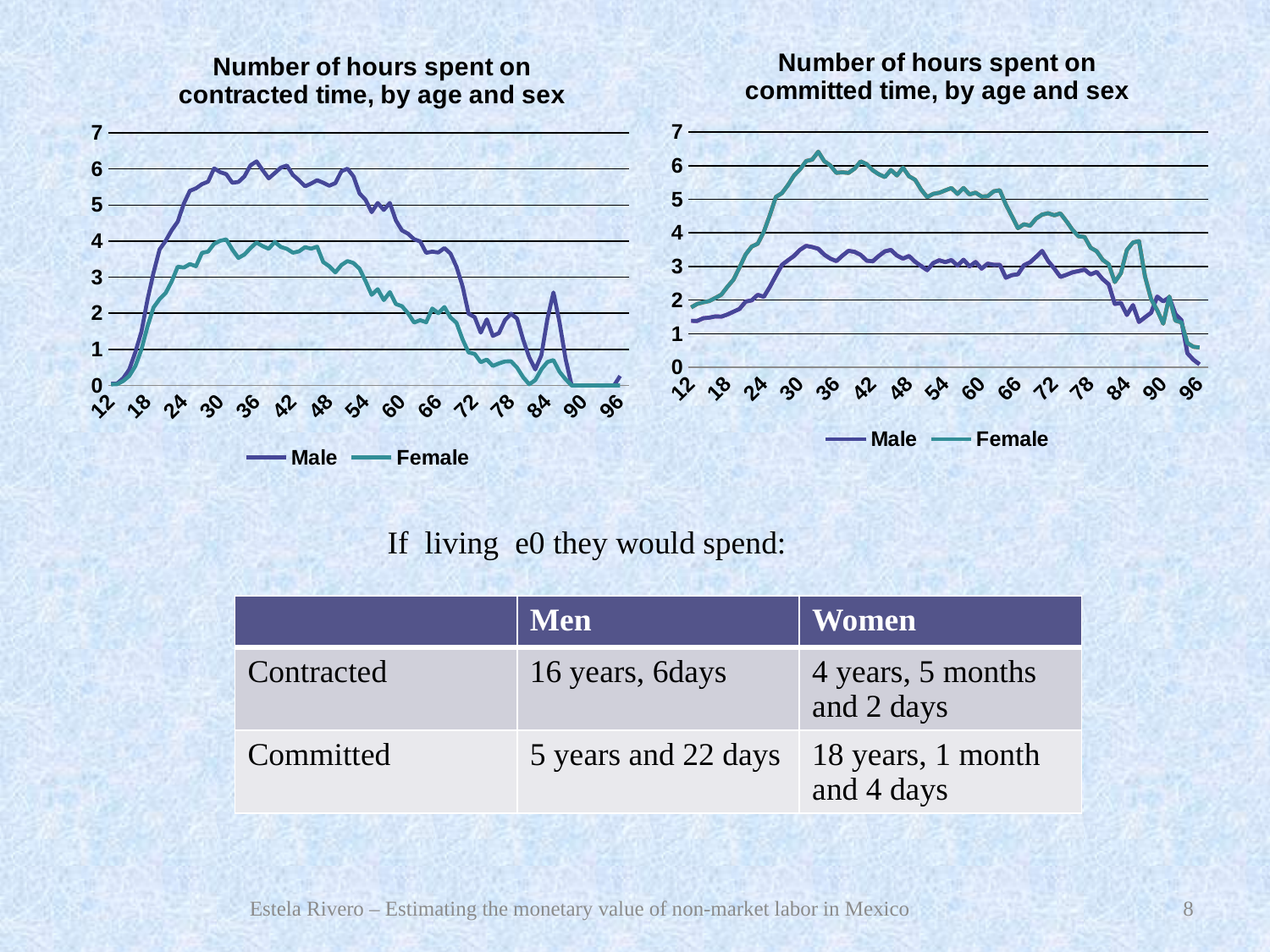
In the right chart (committed time), is the Female value at age 30 greater or less than 5? greater In the left chart (contracted time), does the Male line rise or fall between age 54 and age 90? fall How many series does the legend of the right chart, 'Number of hours spent on committed time, by age and sex', list? 2 In the right chart (committed time), is the Male value at age 12 greater or less than 1? greater In the left chart (contracted time), is the Male value at age 90 greater or less than 1? less What kind of chart is the left chart, 'Number of hours spent on contracted time, by age and sex'? line chart In the right chart (committed time), at age 42, which series has the larger value, Male or Female? Female In the left chart (contracted time), at age 30, which series has the larger value, Male or Female? Male In the right chart (committed time), does the Female line rise or fall between age 36 and age 96? fall In the left chart (contracted time), which series is plotted in purple? Male